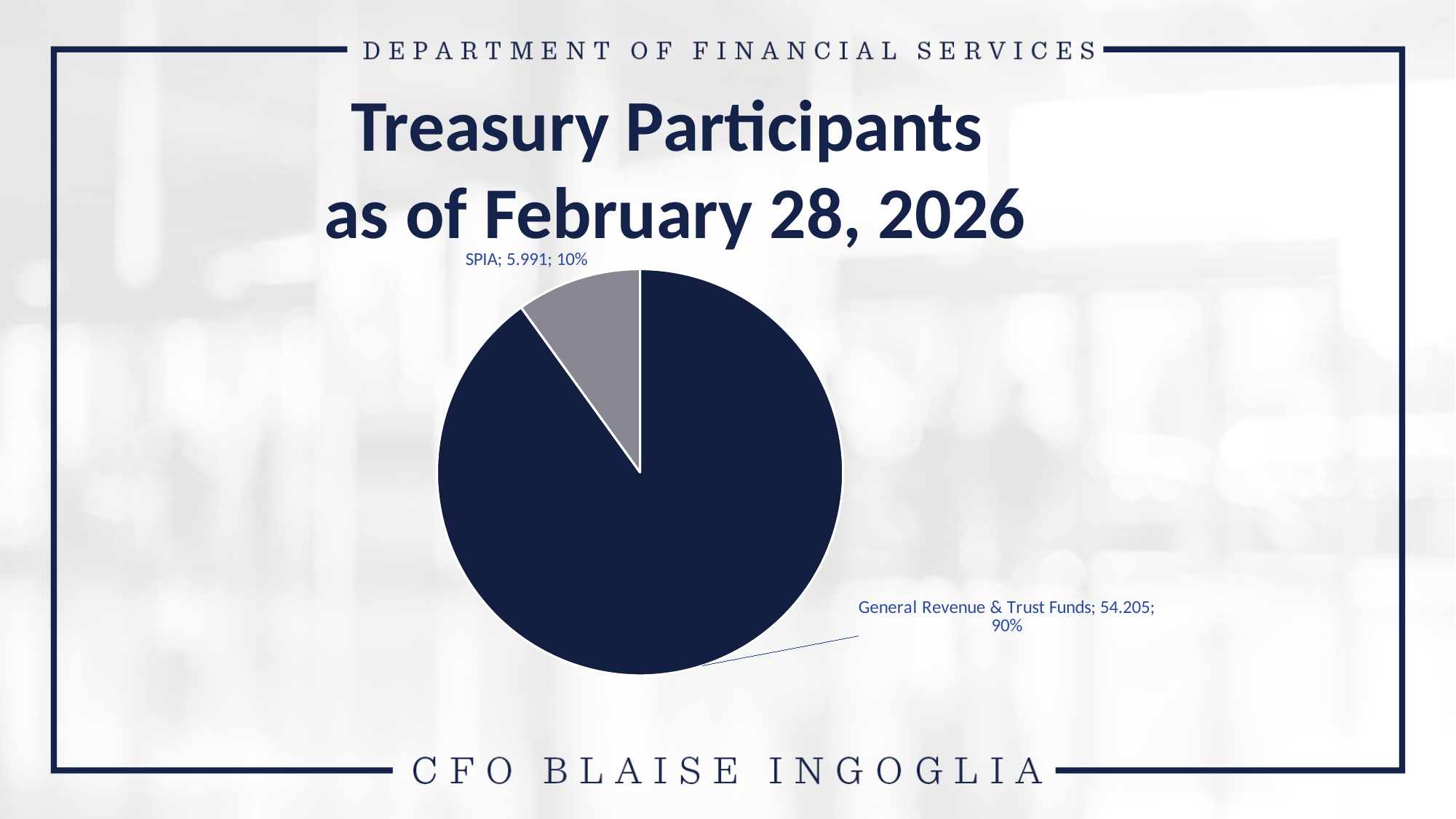
What is the difference between the General Revenue & Trust Funds value and the SPIA value? 48.214 What share of the pie does SPIA represent? 10% How many slices does the pie chart have? 2 Which is larger, SPIA or General Revenue & Trust Funds? General Revenue & Trust Funds What colour is the SPIA slice? grey Which category has the smallest slice? SPIA Which category has the largest slice? General Revenue & Trust Funds What is the value for SPIA? 5.991 What is the value for General Revenue & Trust Funds? 54.205 What is the title of the chart? Treasury Participants as of February 28, 2026 What share of the pie does General Revenue & Trust Funds represent? 90% What type of chart is shown on the slide? pie chart